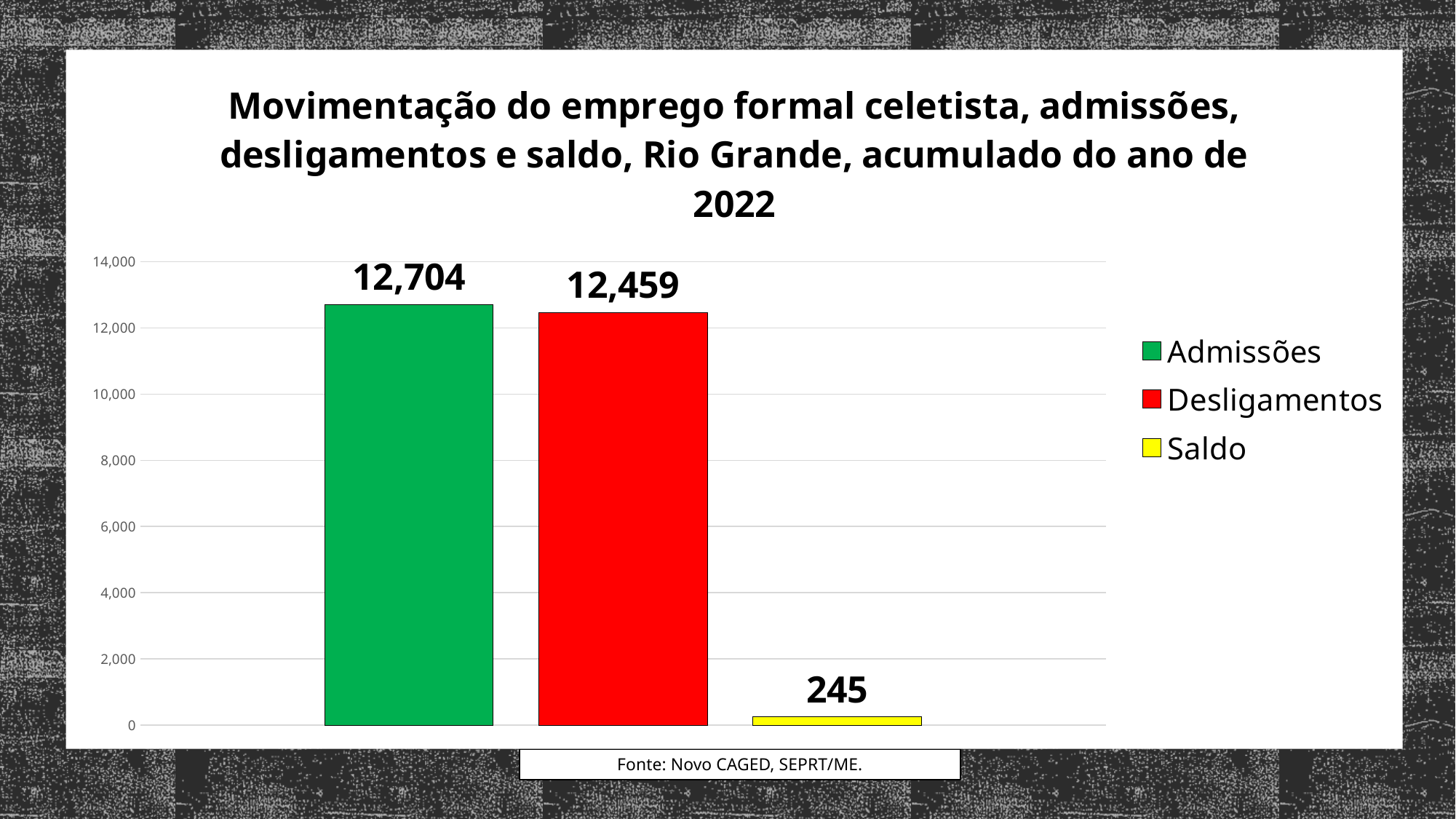
Which series has the lowest value? Saldo What colour is the bar for Saldo? Yellow Which series has the highest value? Admissões Is the value for Saldo greater or less than 2,000? less Which is larger, Desligamentos or Saldo? Desligamentos What is the value for Admissões? 12,704 How many series does the legend list? 3 What kind of chart is shown on the slide? Bar chart What is the value for Saldo? 245 Is the value for Admissões greater or less than 12,000? greater What is the value for Desligamentos? 12,459 What is the difference between Admissões and Desligamentos? 245